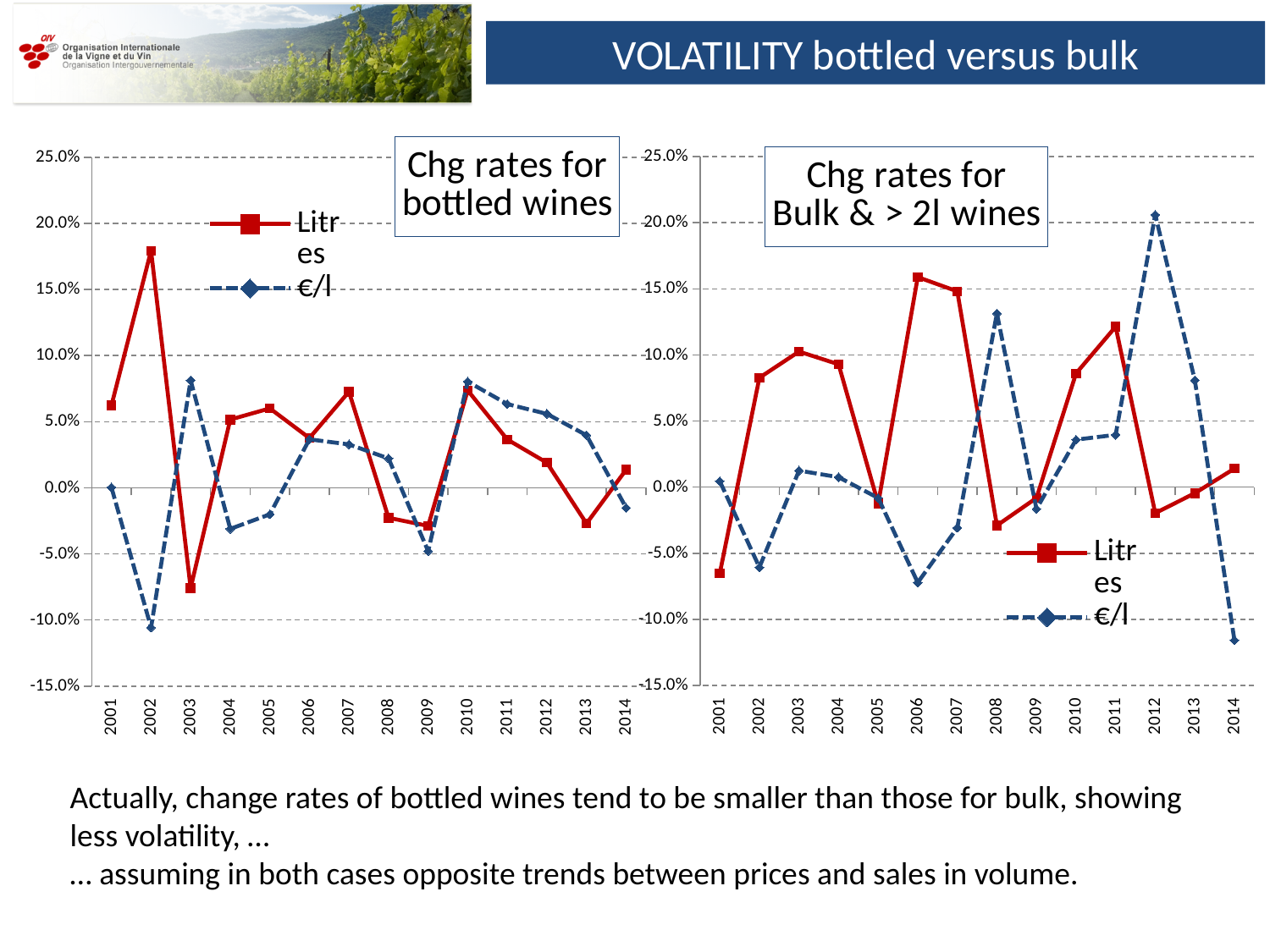
In the 'Chg rates for bottled wines' chart, which series has the larger value in 2002, Litres or €/l? Litres In the 'Chg rates for Bulk & > 2l wines' chart, in which year does the €/l series reach its highest value? 2012 What kind of chart is the 'Chg rates for bottled wines' chart? line chart In the 'Chg rates for bottled wines' chart, in which year does the €/l series reach its lowest value? 2002 What is the title of the right-hand chart on the slide? Chg rates for Bulk & > 2l wines How many years are plotted along the x axis of the 'Chg rates for bottled wines' chart? 14 In the 'Chg rates for bottled wines' chart, is the Litres value for 2002 greater or less than 15.0%? greater In the 'Chg rates for Bulk & > 2l wines' chart, is the Litres value for 2006 greater or less than 10.0%? greater In the 'Chg rates for Bulk & > 2l wines' chart, in which year does the €/l series reach its lowest value? 2014 In the 'Chg rates for Bulk & > 2l wines' chart, is the €/l value for 2014 greater or less than -10.0%? less How many series does the legend of the 'Chg rates for Bulk & > 2l wines' chart list? 2 In the 'Chg rates for bottled wines' chart, in which year does the Litres series reach its highest value? 2002